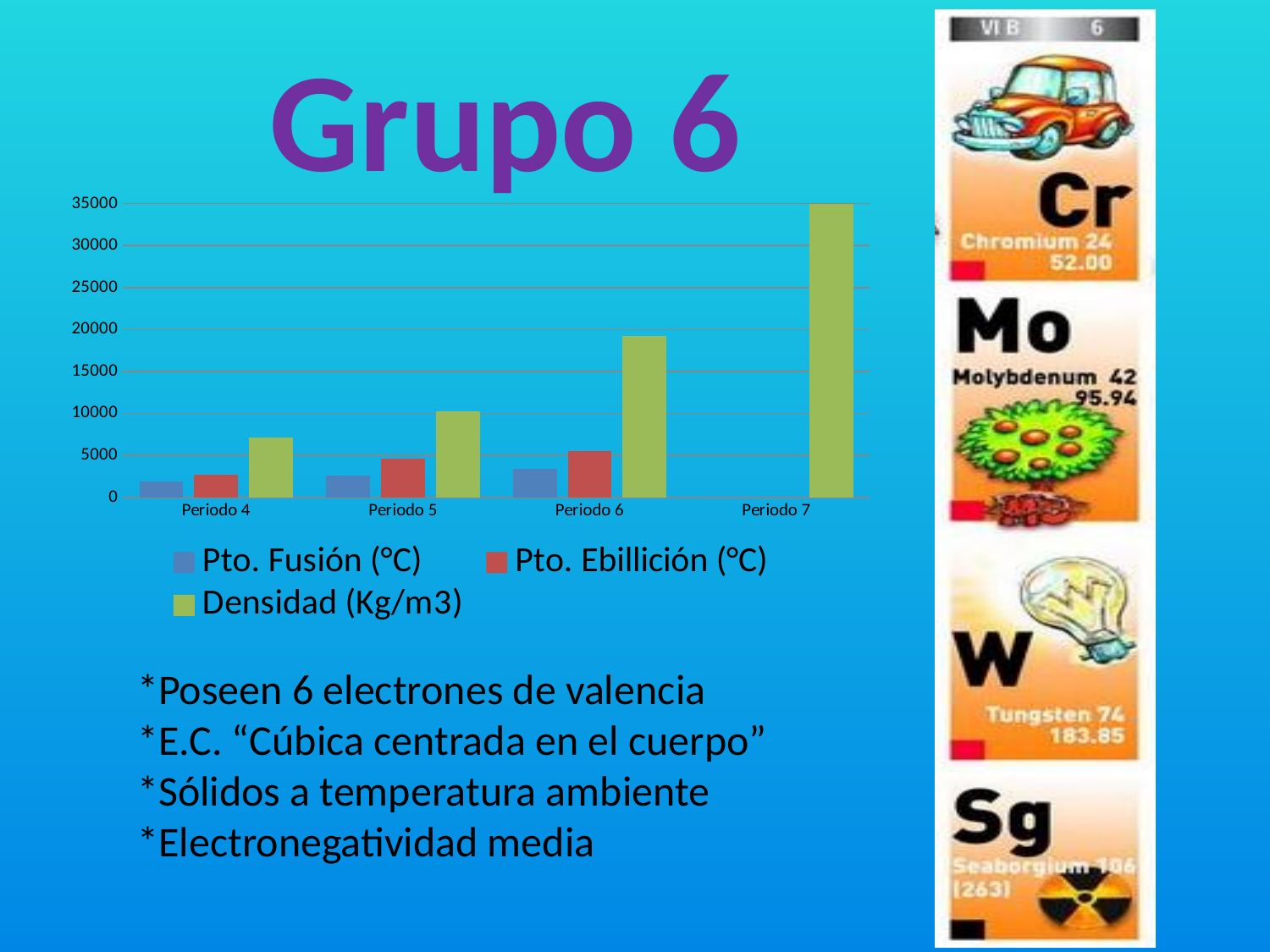
Which period has the tallest Densidad (Kg/m3) bar? Periodo 7 Is the Densidad (Kg/m3) value for Periodo 4 greater or less than 5000? greater What kind of chart is shown on the slide? bar chart Is the Densidad (Kg/m3) value for Periodo 6 greater or less than 15000? greater How many series does the chart legend list? 3 Is the Densidad (Kg/m3) value for Periodo 5 greater or less than 15000? less How many period categories are shown on the x axis of the chart? 4 Does the Densidad (Kg/m3) series rise or fall from Periodo 4 to Periodo 7? rise Which is larger, the Densidad (Kg/m3) value for Periodo 5 or for Periodo 6? Periodo 6 What colour are the Densidad (Kg/m3) bars in the chart? green